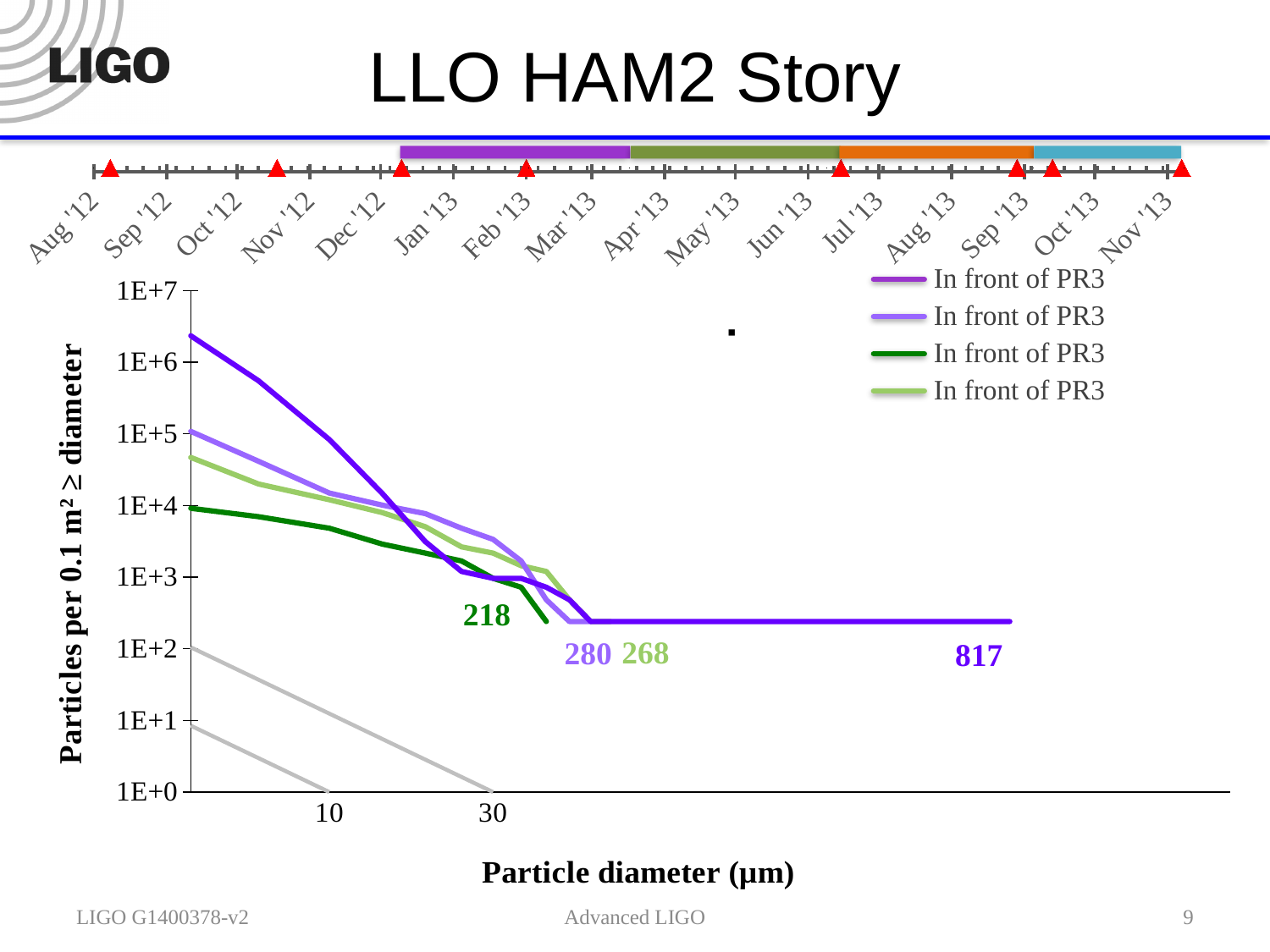
What type of chart is shown on the slide? line chart Is the value of the dark green line at the left edge of the chart greater or less than 1E+5? less What number is printed in green near the end of the dark green line? 218 Of the four numeric labels printed on the chart (218, 280, 268, 817), which is the largest? 817 What is the highest tick label shown on the y axis of the chart? 1E+7 What number is printed in dark purple near the right end of the dark purple line? 817 Is the value of the dark purple line at the left edge of the chart greater or less than 1E+6? greater Do the plotted lines rise or fall as particle diameter increases along the x axis? fall How many series does the chart legend list? 4 What is the title of the x axis of the chart? Particle diameter (µm) Which line has the highest value at the smallest particle diameter (left edge of the chart)? the dark purple line